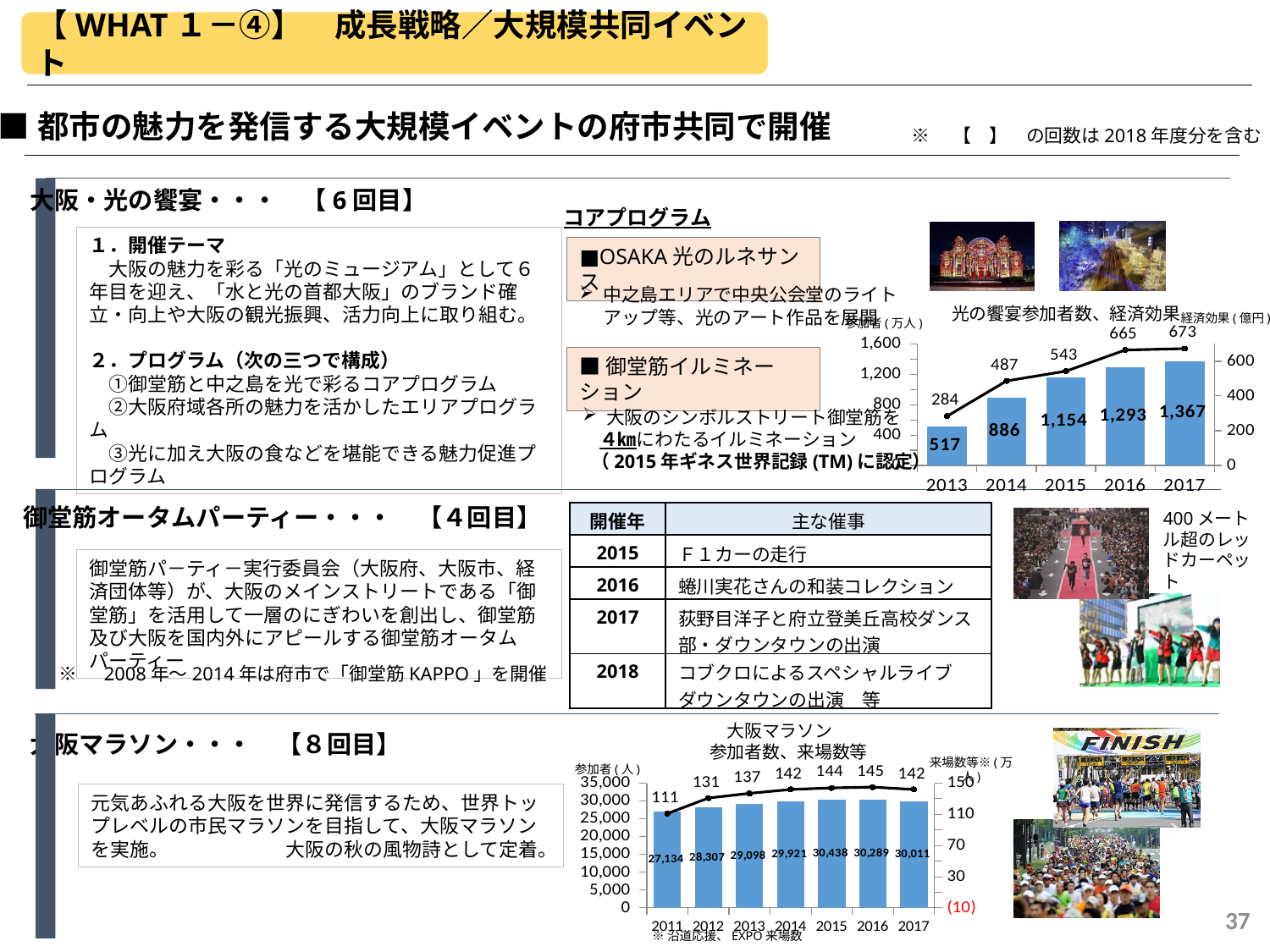
In the 光の饗宴参加者数、経済効果 chart, what is the 参加者 value for 2013? 517 In the 大阪マラソン 参加者数、来場数等 chart, which is larger, the 参加者 value for 2016 or for 2017? 2016 In the 光の饗宴参加者数、経済効果 chart, what is the difference between the 参加者 values for 2017 and 2013? 850 In the 光の饗宴参加者数、経済効果 chart, what is the 経済効果 value for 2017? 673 In the 大阪マラソン 参加者数、来場数等 chart, what is the 参加者 value for 2015? 30,438 In the 大阪マラソン 参加者数、来場数等 chart, what is the 来場数等 value for 2016? 145 In the 光の饗宴参加者数、経済効果 chart, which year has the highest 参加者 value? 2017 What kind of chart is the 大阪マラソン 参加者数、来場数等 chart? bar chart with a line In the 光の饗宴参加者数、経済効果 chart, how many years are shown on the x axis? 5 In the 光の饗宴参加者数、経済効果 chart, does the 経済効果 line rise or fall from 2013 to 2017? rise In the 大阪マラソン 参加者数、来場数等 chart, which year has the lowest 参加者 value? 2011 In the 大阪マラソン 参加者数、来場数等 chart, what is the difference between the 来場数等 values for 2012 and 2011? 20